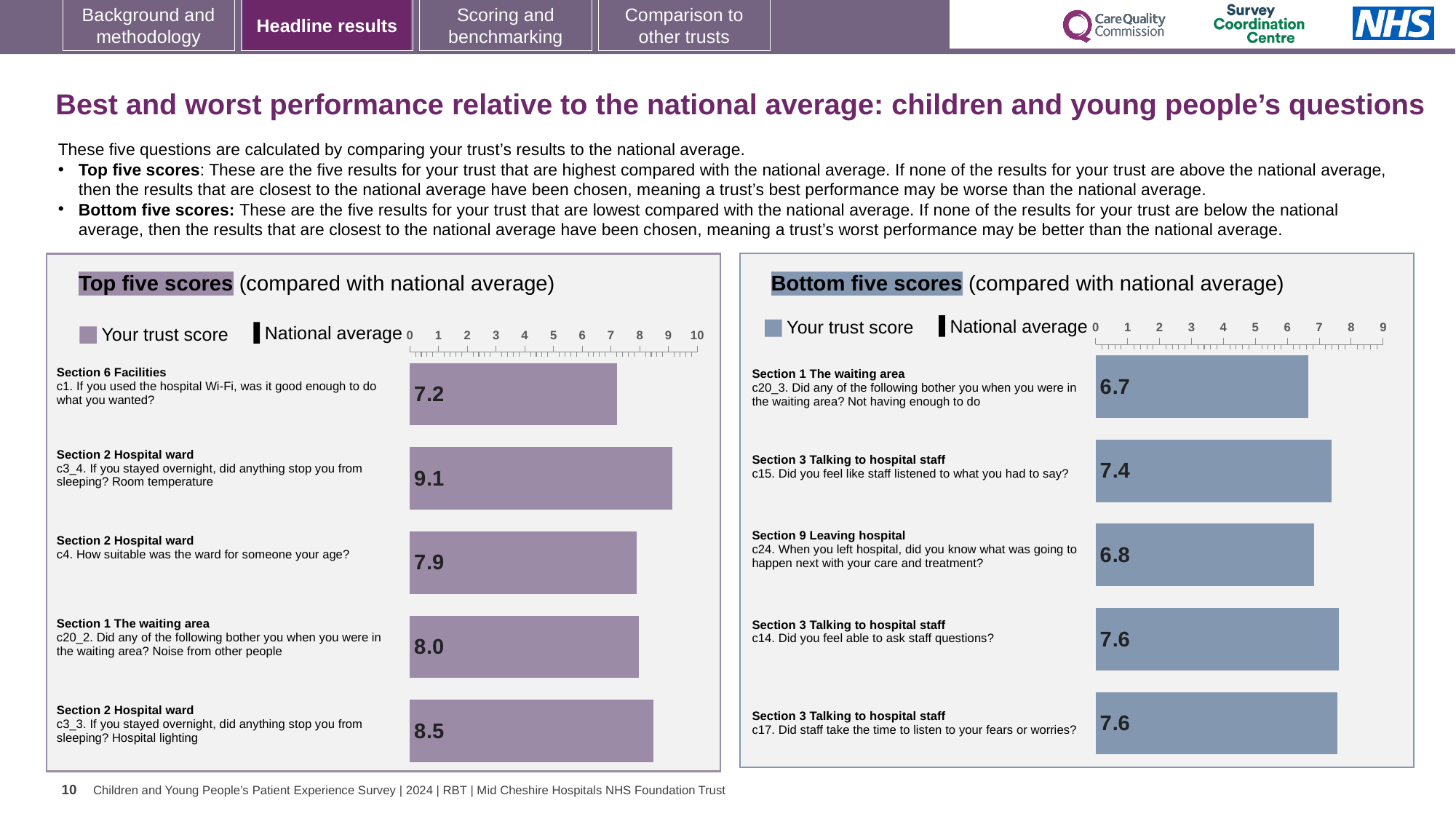
In the Top five scores chart, what is the trust score for c3_4 (room temperature stopping sleep)? 9.1 In the Bottom five scores chart, which question has the lowest trust score? c20_3 (not having enough to do in the waiting area) In the Top five scores chart, what is the difference between the scores for c3_3 (hospital lighting) and c4 (ward suitability for your age)? 0.6 How many questions are shown in the Bottom five scores chart? 5 In the Top five scores chart, which question has the highest trust score? c3_4 (room temperature stopping sleep) In the Top five scores chart, what is the trust score for c1 (hospital Wi-Fi)? 7.2 In the Bottom five scores chart, what is the difference between the scores for c14 (able to ask staff questions) and c20_3 (not having enough to do)? 0.9 In the Bottom five scores chart, what is the trust score for c24 (knowing what was going to happen next when leaving hospital)? 6.8 How many series does the legend of the Bottom five scores chart list? 2 In the Top five scores chart, which is larger: the score for c20_2 (noise from other people) or c1 (hospital Wi-Fi)? c20_2 (noise from other people) What type of chart is the Top five scores chart? Bar chart In the Bottom five scores chart, what is the trust score for c15 (staff listened to what you had to say)? 7.4